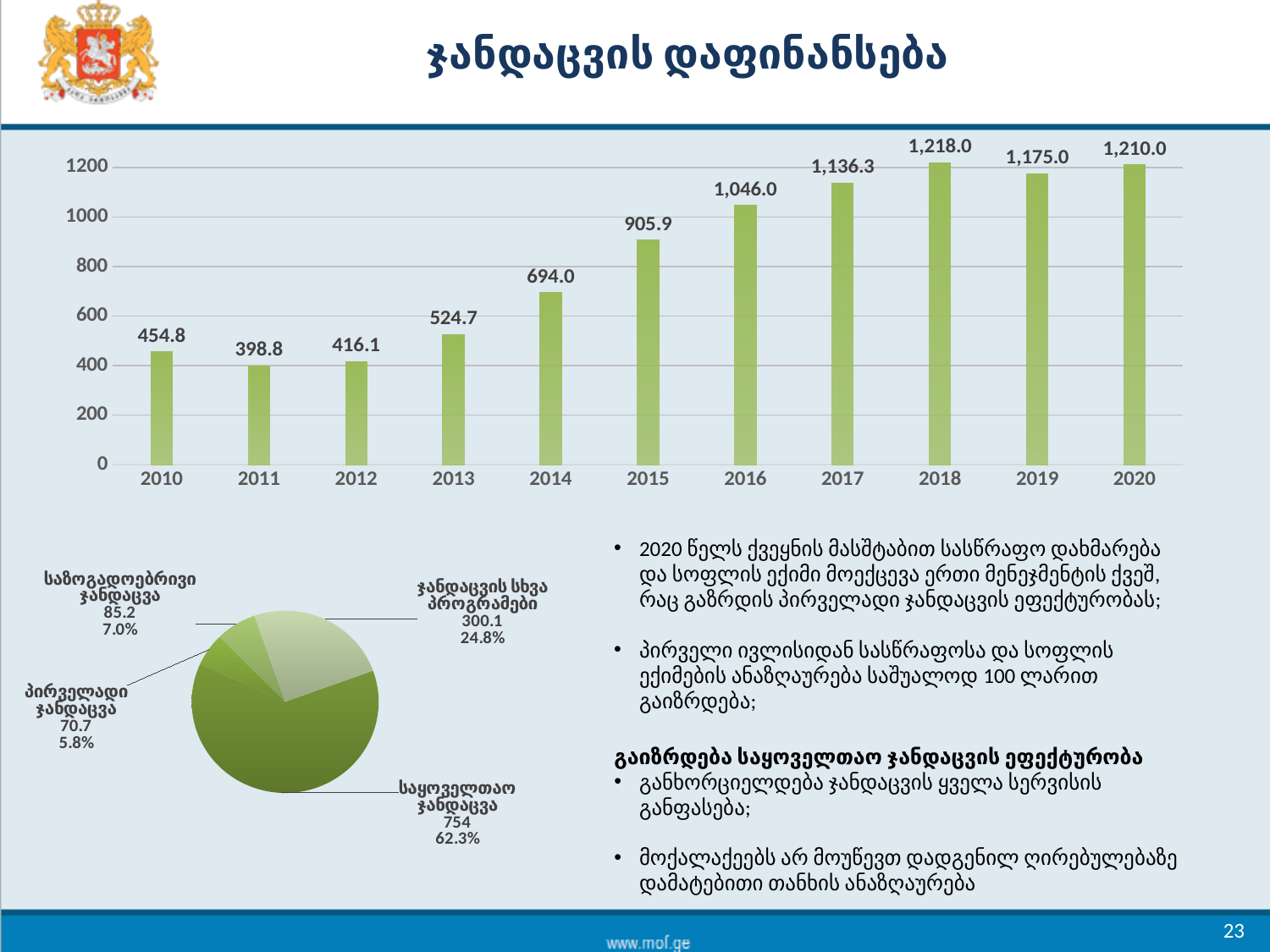
In the bar chart at the top, what is the value for 2020? 1,210.0 In the bar chart at the top, do the values generally rise or fall from 2011 to 2018? rise In the bar chart at the top, how many years are shown on the x axis? 11 In the bar chart at the top, which year has the highest value? 2018 In the pie chart at the bottom left, what share does საყოველთაო ჯანდაცვა have? 62.3% In the pie chart at the bottom left, what is the value for ჯანდაცვის სხვა პროგრამები? 300.1 In the bar chart at the top, which is larger, the value for 2012 or the value for 2013? 2013 In the bar chart at the top, which year has the lowest value? 2011 What kind of chart is the chart at the top of the slide? bar chart In the bar chart at the top, what is the value for 2015? 905.9 In the bar chart at the top, what is the difference between the values for 2018 and 2019? 43.0 In the pie chart at the bottom left, how many slices are there? 4